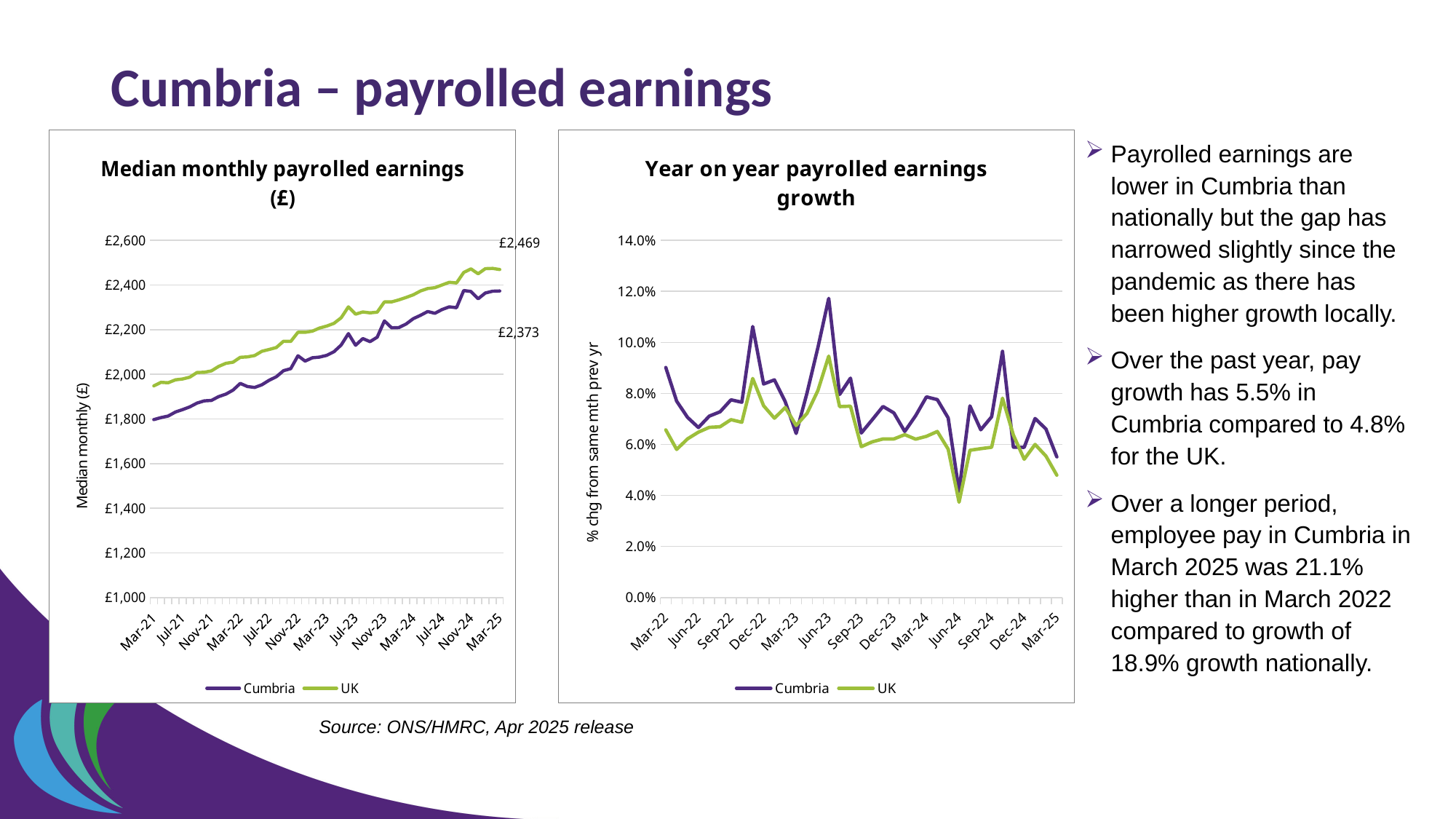
In the 'Year on year payrolled earnings growth' chart, which series is represented by the purple line? Cumbria In the 'Year on year payrolled earnings growth' chart, is the UK value at Mar-25 greater or less than 6.0%? less In the 'Median monthly payrolled earnings (£)' chart, is the Cumbria value at Mar-21 greater or less than £2,000? less What kind of chart is the 'Median monthly payrolled earnings (£)' chart on the left? line chart How many series does the legend of the 'Year on year payrolled earnings growth' chart list? 2 In the 'Median monthly payrolled earnings (£)' chart, what is the difference between the labelled UK and Cumbria values at Mar-25? £96 In the 'Median monthly payrolled earnings (£)' chart, does the Cumbria line generally rise or fall from Mar-21 to Mar-25? rise In the 'Year on year payrolled earnings growth' chart, is the Cumbria value at Jun-23 greater or less than 10.0%? greater In the 'Median monthly payrolled earnings (£)' chart, what is the Cumbria value labelled at Mar-25? £2,373 In the 'Median monthly payrolled earnings (£)' chart, what is the UK value labelled at Mar-25? £2,469 In the 'Median monthly payrolled earnings (£)' chart, which series has the higher value at Mar-25, Cumbria or UK? UK How many series does the legend of the 'Median monthly payrolled earnings (£)' chart list? 2